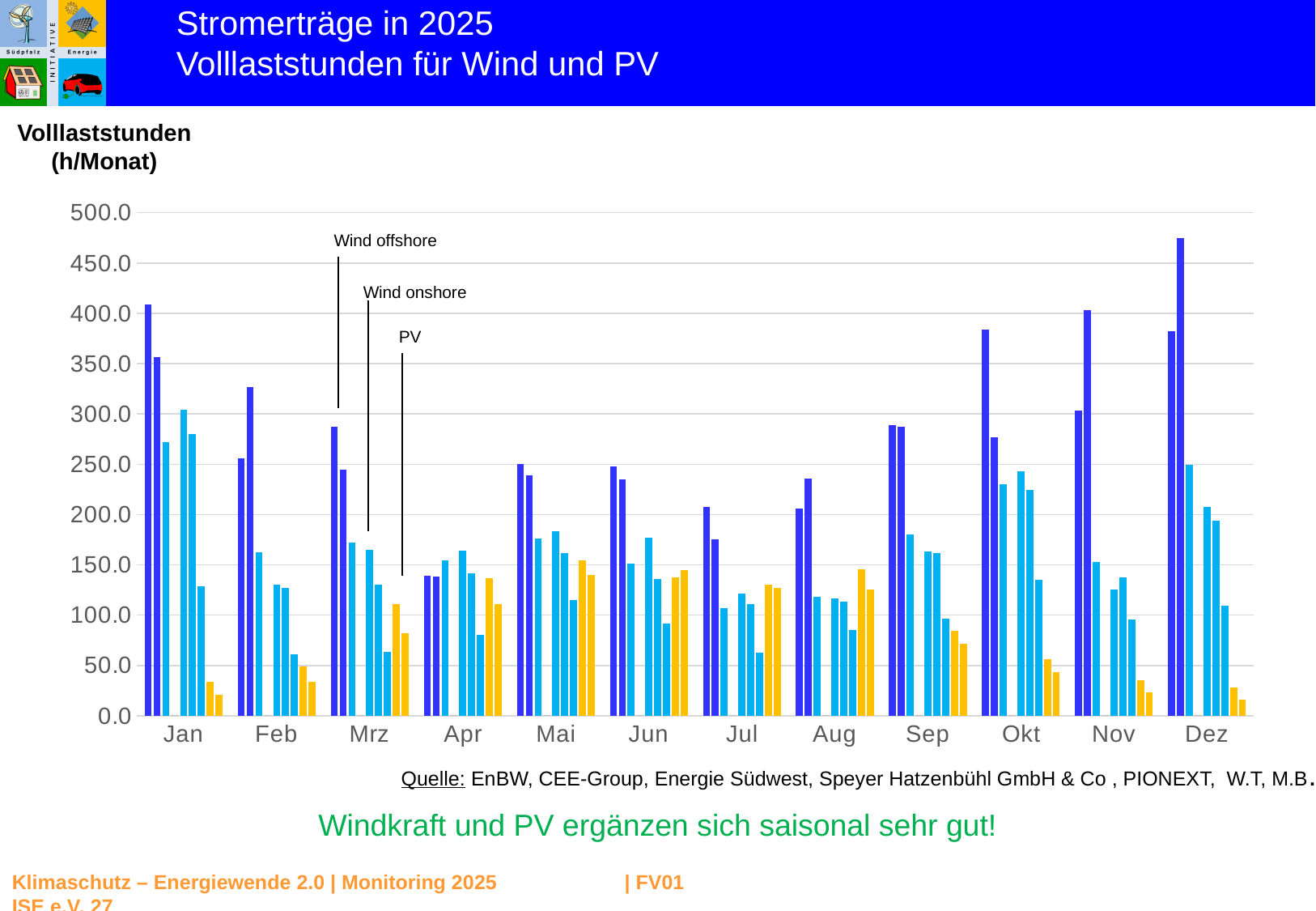
How many series are labelled on the chart (Wind offshore, Wind onshore, PV)? 3 Do the PV bars generally rise or fall from Jan to Jun? rise What is the unit shown for the y axis of the chart? h/Monat Is the tallest Wind offshore bar in Dez greater or less than 450? greater Is the first Wind offshore bar in Jan greater or less than 350? greater Are the Wind offshore bars in Apr greater or less than 200? less What kind of chart is shown on the slide? bar chart In which month does the tallest Wind offshore bar occur? Dez Which is larger, the first Wind offshore bar in Jan or the first Wind offshore bar in Jul? Jan How many months are shown along the x axis of the chart? 12 Which series is drawn in yellow on the chart? PV